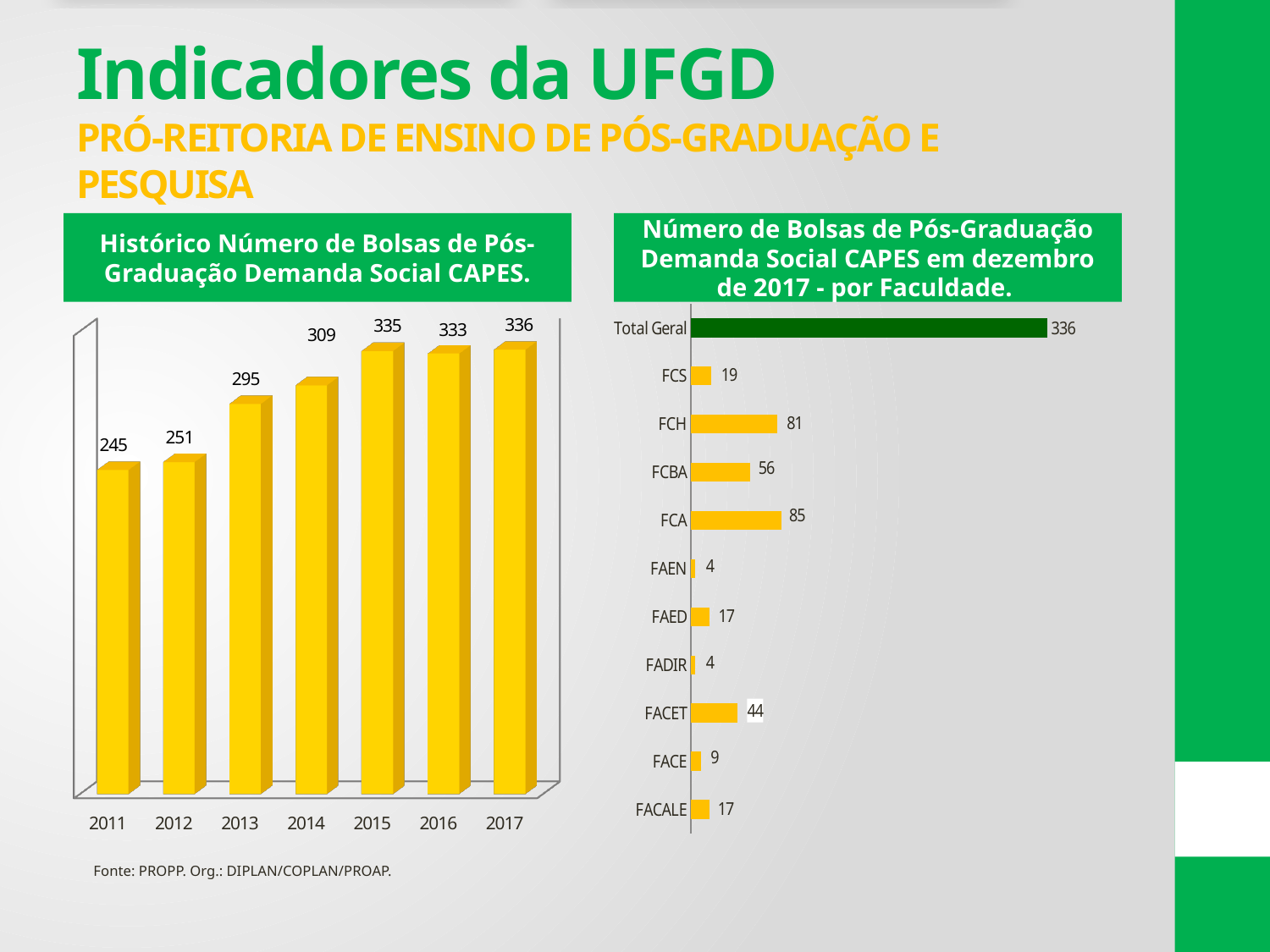
In the right chart (Número de Bolsas por Faculdade), what is the value for Total Geral? 336 What type of chart is the right chart (Número de Bolsas por Faculdade)? bar chart In the right chart (Número de Bolsas por Faculdade), what is the difference between FCA and FCS? 66 In the left chart (Histórico Número de Bolsas), how many years are shown on the x axis? 7 In the right chart (Número de Bolsas por Faculdade), which faculty (excluding Total Geral) has the highest value? FCA In the right chart (Número de Bolsas por Faculdade), what is the value for FCH? 81 In the left chart (Histórico Número de Bolsas), what is the difference between the values for 2013 and 2012? 44 In the right chart (Número de Bolsas por Faculdade), which is larger, FCBA or FACET? FCBA In the left chart (Histórico Número de Bolsas), which year has the highest value? 2017 In the left chart (Histórico Número de Bolsas de Pós-Graduação Demanda Social CAPES), what is the value for 2014? 309 In the left chart (Histórico Número de Bolsas), do the values generally rise or fall from 2011 to 2017? rise In the left chart (Histórico Número de Bolsas), which year has the lowest value? 2011